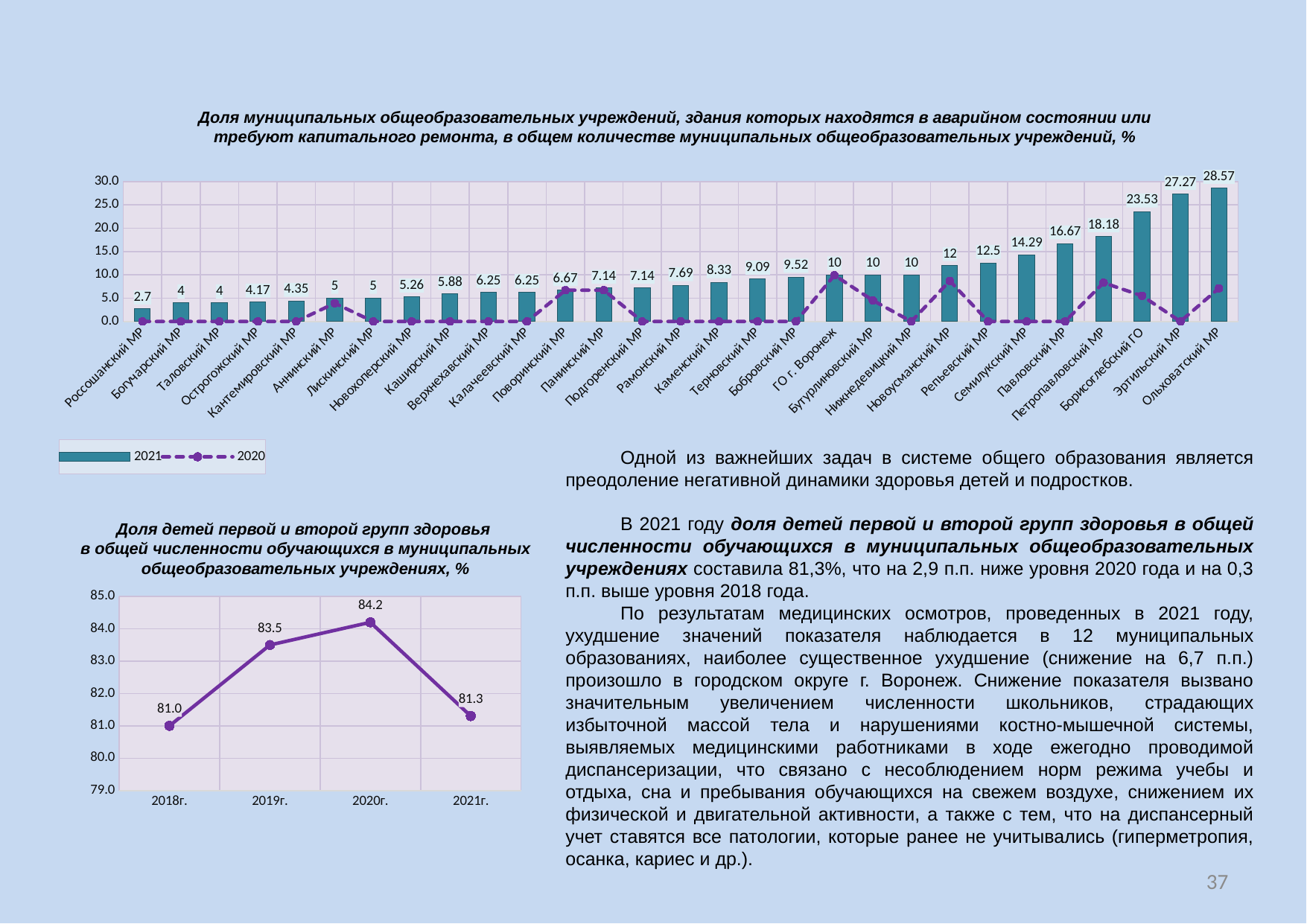
How many data points are plotted in the bottom-left chart? 4 How many series does the legend of the top chart list? 2 In the bottom-left chart, what is the difference between the values for 2020г. and 2021г.? 2.9 In the top chart, what is the 2021 value for Борисоглебский ГО? 23.53 In the bottom-left chart, what is the value for 2020г.? 84.2 In the top chart, what is the 2021 value for Ольховатский МР? 28.57 What kind of chart is the bottom-left chart? line chart In the top chart, which has the larger 2021 value: Семилукский МР or Павловский МР? Павловский МР In the top chart, is the 2020 value for ГО г. Воронеж greater or less than 5? greater In the top chart, what is the difference between the 2021 values for Ольховатский МР and Эртильский МР? 1.3 In the top chart, which category has the lowest 2021 value? Россошанский МР In the bottom-left chart, which year has the highest value? 2020г.